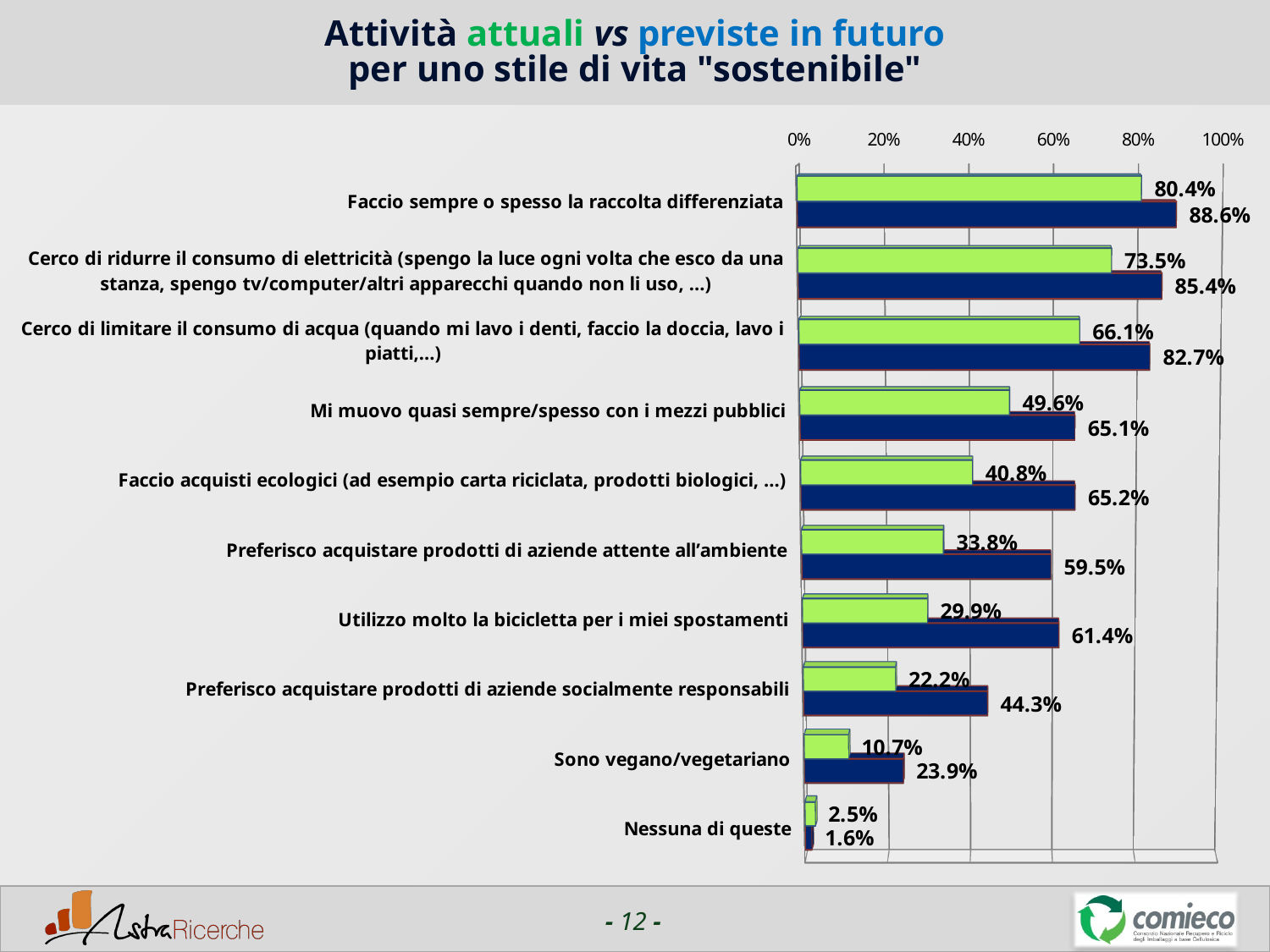
Is the green (attuali) value for "Preferisco acquistare prodotti di aziende attente all'ambiente" greater or less than 40%? less What is the value of the blue (previste in futuro) bar for "Nessuna di queste"? 1.6% What type of chart is shown on the slide? Bar chart What is the value of the green (attuali) bar for "Faccio sempre o spesso la raccolta differenziata"? 80.4% Which category has the highest blue (previste in futuro) value? Faccio sempre o spesso la raccolta differenziata What is the difference between the blue and green values for "Faccio sempre o spesso la raccolta differenziata"? 8.2 percentage points Which category has the lowest green (attuali) value? Nessuna di queste What is the difference between the blue and green values for "Utilizzo molto la bicicletta per i miei spostamenti"? 31.5 percentage points How many categories are shown in the chart? 10 Which has the larger green (attuali) value: "Mi muovo quasi sempre/spesso con i mezzi pubblici" or "Faccio acquisti ecologici"? Mi muovo quasi sempre/spesso con i mezzi pubblici How many data series are plotted in the chart? 2 What is the value of the blue (previste in futuro) bar for "Sono vegano/vegetariano"? 23.9%